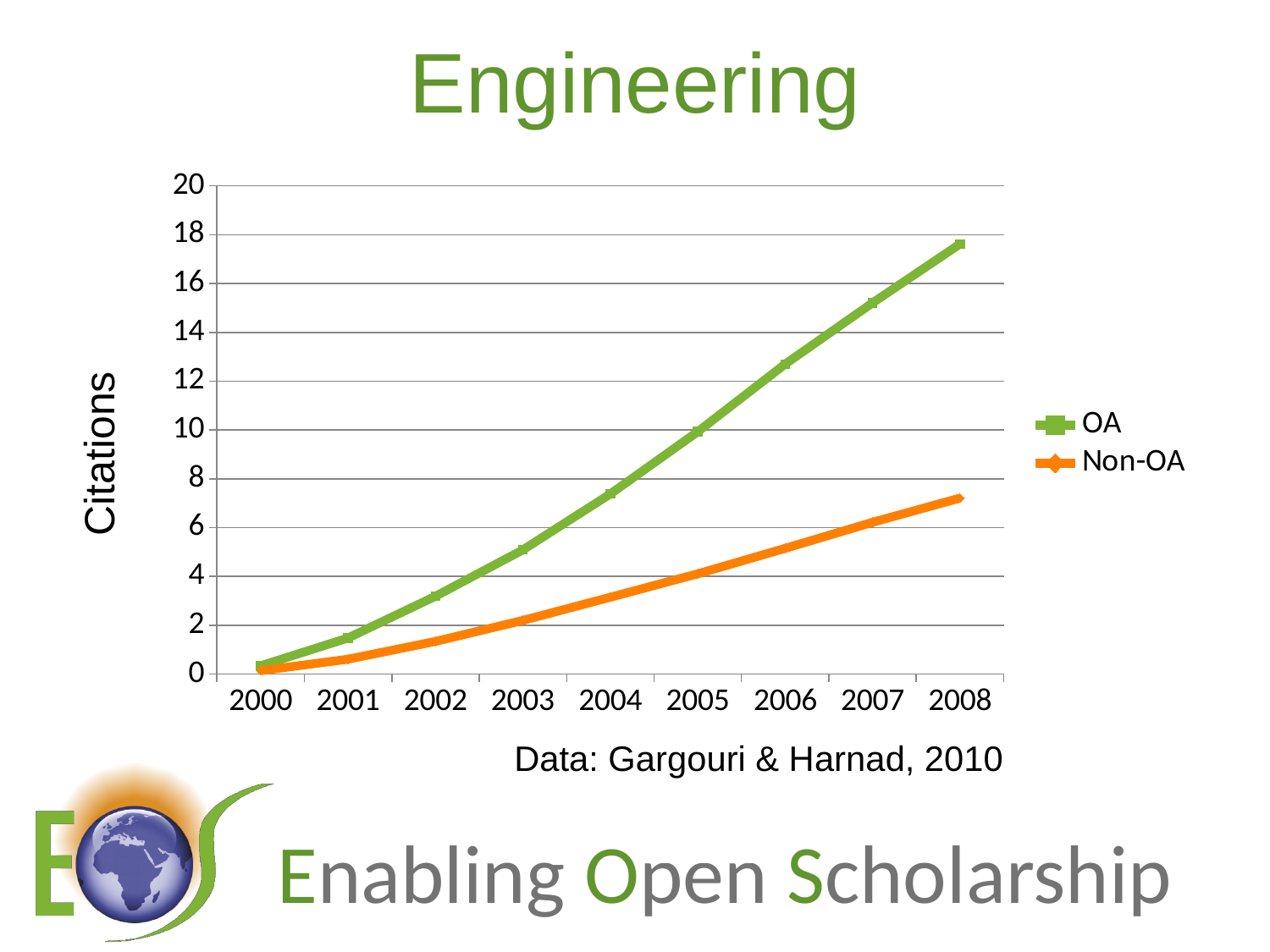
How many series does the legend list? 2 Is the OA value for 2008 greater or less than 16? greater Do the OA citations rise or fall from 2000 to 2008? rise Is the Non-OA value for 2004 greater or less than 4? less What kind of chart is shown on the slide? line chart Is the Non-OA value for 2008 greater or less than 8? less In which year is the OA series at its highest? 2008 In 2008, which series has more citations, OA or Non-OA? OA How many years are plotted along the x axis? 9 In which year is the Non-OA series at its lowest? 2000 What is the label on the vertical axis of the chart? Citations